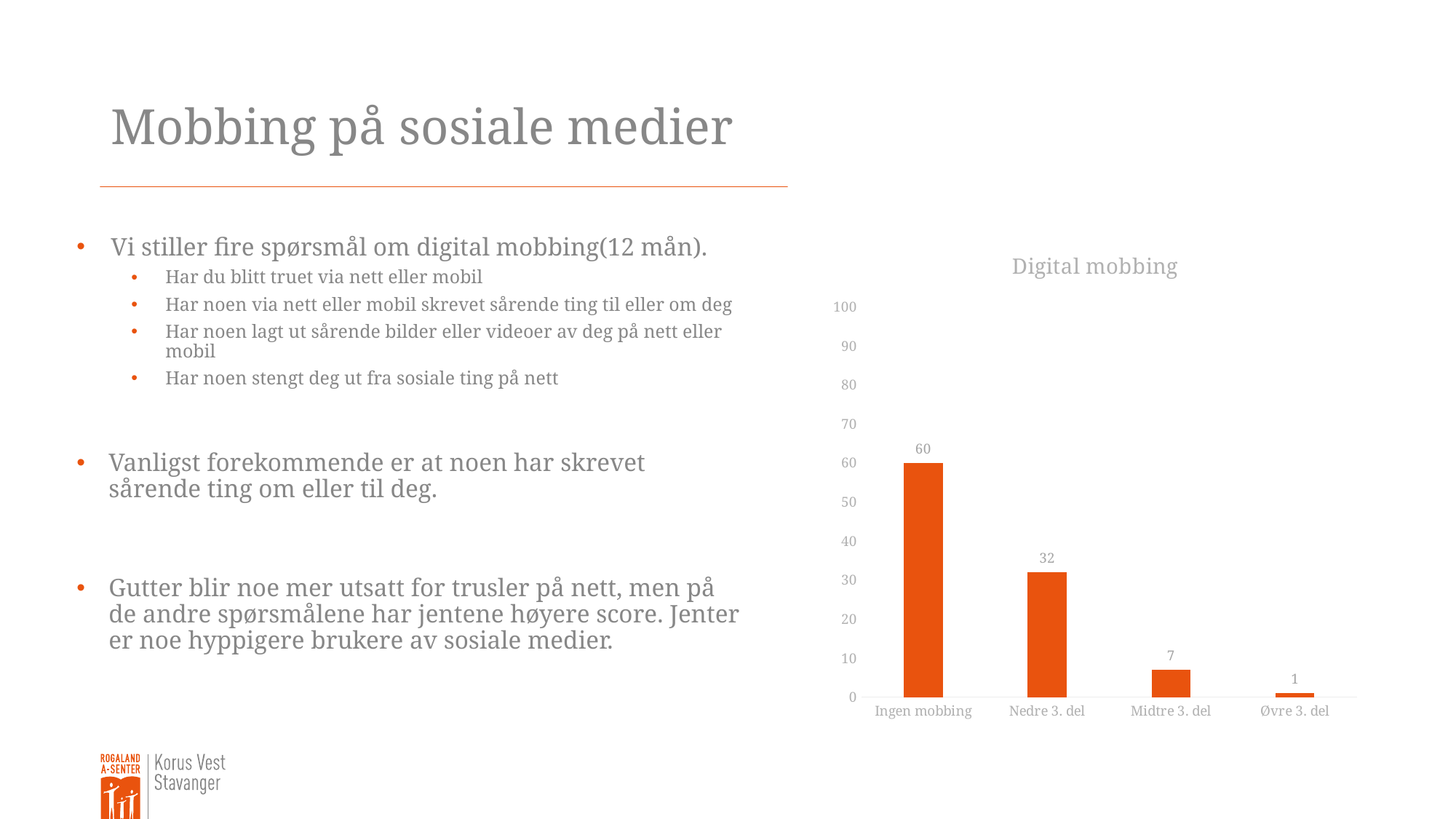
Which is larger, the value for Nedre 3. del or the value for Midtre 3. del? Nedre 3. del Which category has the lowest value in the Digital mobbing chart? Øvre 3. del What is the value for Øvre 3. del in the Digital mobbing chart? 1 What is the title of the chart on the slide? Digital mobbing What kind of chart is shown on the slide? bar chart What is the value for Nedre 3. del in the Digital mobbing chart? 32 Which category has the highest value in the Digital mobbing chart? Ingen mobbing What is the value for Midtre 3. del in the Digital mobbing chart? 7 Is the value for Ingen mobbing greater or less than 50? greater What is the value for Ingen mobbing in the Digital mobbing chart? 60 What is the difference between the values for Ingen mobbing and Nedre 3. del? 28 How many categories are shown on the x axis of the Digital mobbing chart? 4